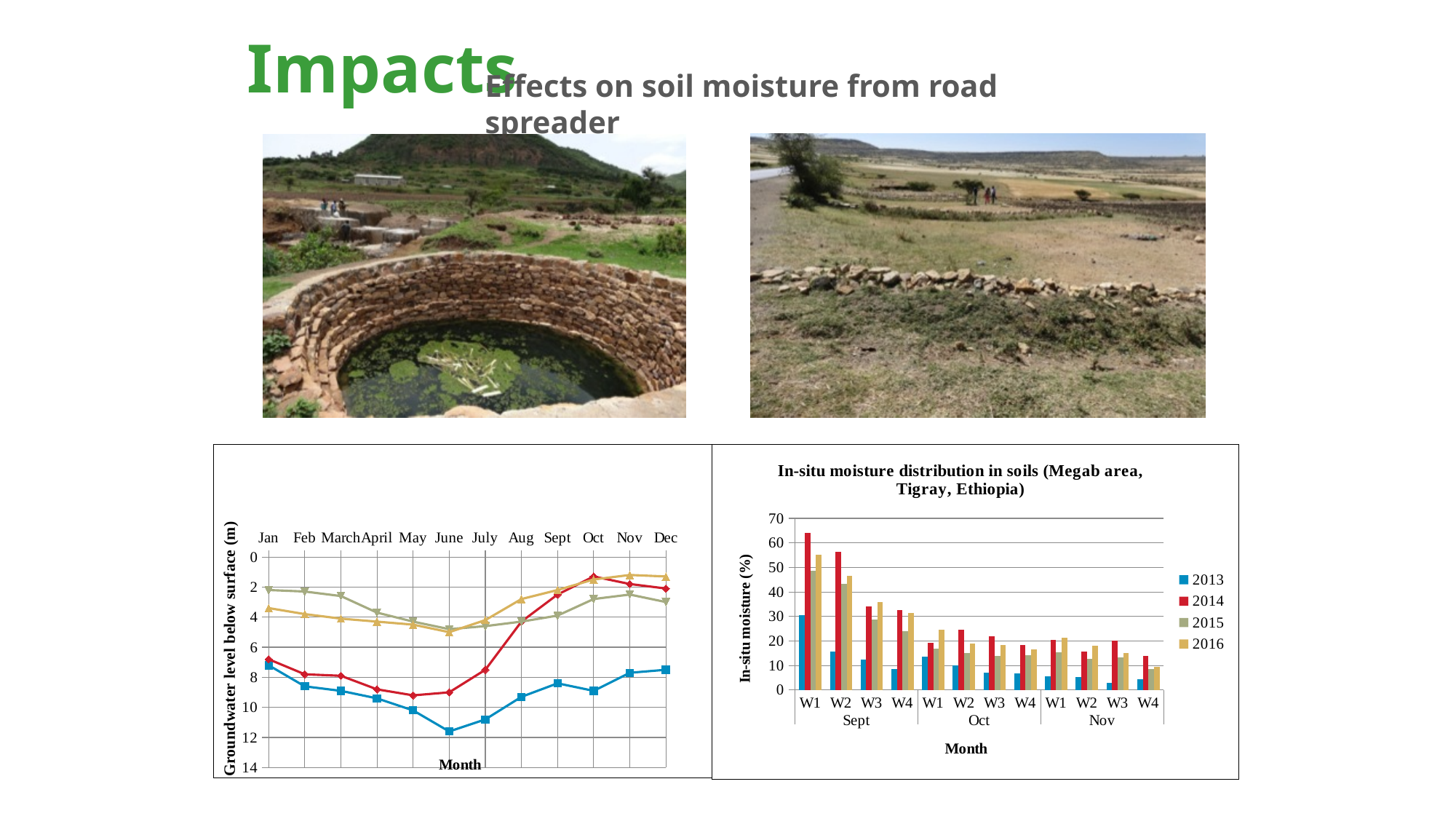
How many months are shown on the x axis of the groundwater level chart on the left? 12 In the 'In-situ moisture distribution in soils' chart, is the 2013 value for Nov W3 greater or less than 10? less In the 'In-situ moisture distribution in soils' chart, is the 2014 value for Sept W1 greater or less than 60? greater In the 'In-situ moisture distribution in soils' chart, which year has the lowest bar for Sept W1? 2013 What kind of chart is the 'In-situ moisture distribution in soils (Megab area, Tigray, Ethiopia)' chart? bar chart In the 'In-situ moisture distribution in soils' chart, do the 2013 values rise or fall from Sept W1 to Sept W4? fall How many series does the legend of the 'In-situ moisture distribution in soils' chart list? 4 In the 'In-situ moisture distribution in soils' chart, which year has the highest bar for Sept W1? 2014 How many week categories are shown on the x axis of the 'In-situ moisture distribution in soils' chart? 12 What is the y-axis label of the groundwater level chart on the left of the slide? Groundwater level below surface (m) What kind of chart is the groundwater level chart on the left of the slide? line chart In the 'In-situ moisture distribution in soils' chart, which is larger for Sept W2: the 2014 value or the 2016 value? 2014